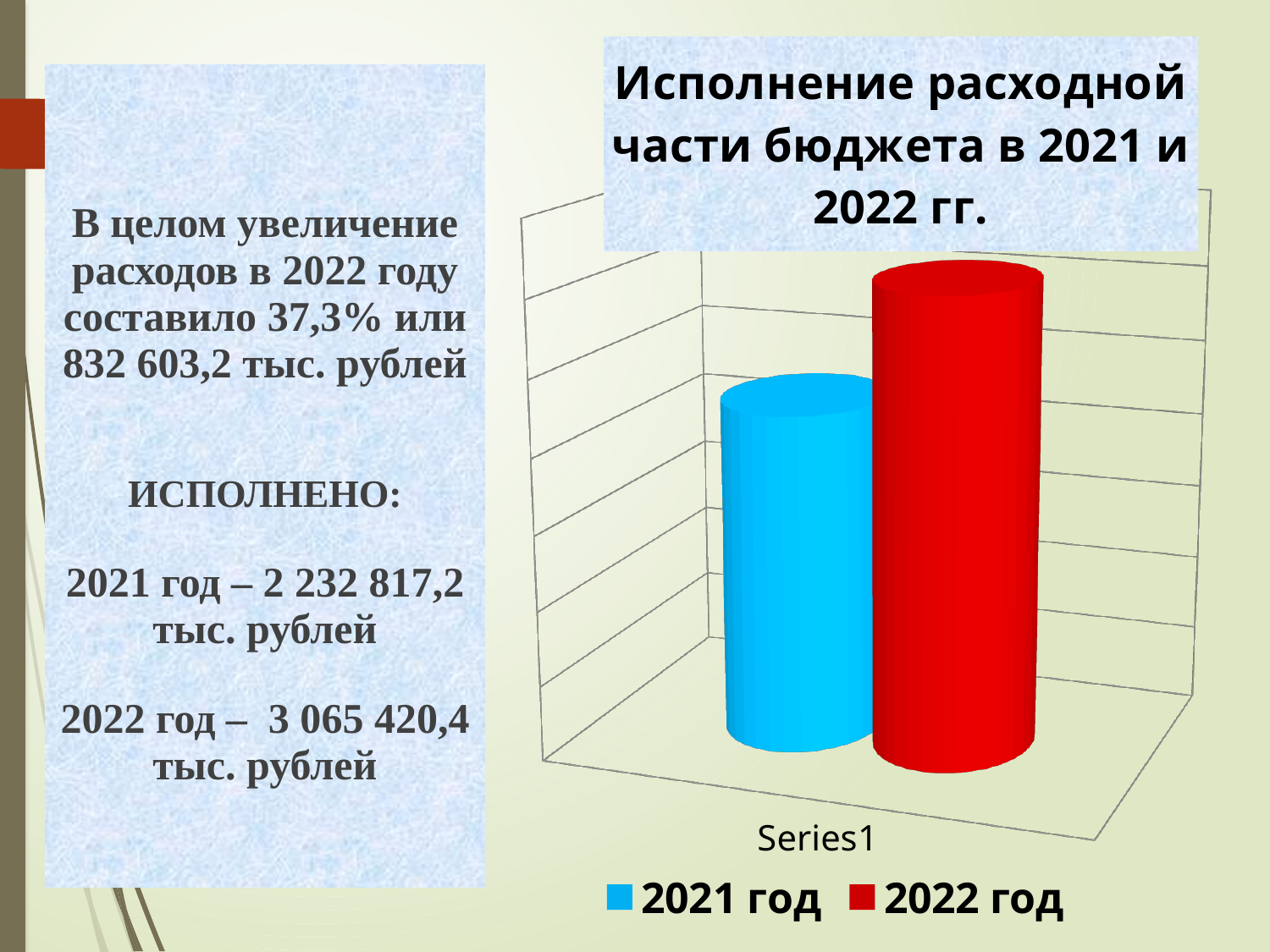
What is the category label shown on the horizontal axis? Series1 Which series has the taller bar, 2021 год or 2022 год? 2022 год What kind of chart is shown on the slide? bar chart Which series has the highest value in the chart? 2022 год What is the title of the chart? Исполнение расходной части бюджета в 2021 и 2022 гг. Which series has the lowest value in the chart? 2021 год How many bars are plotted in the chart? 2 How many series does the chart legend list? 2 What colour is the bar for 2022 год? red